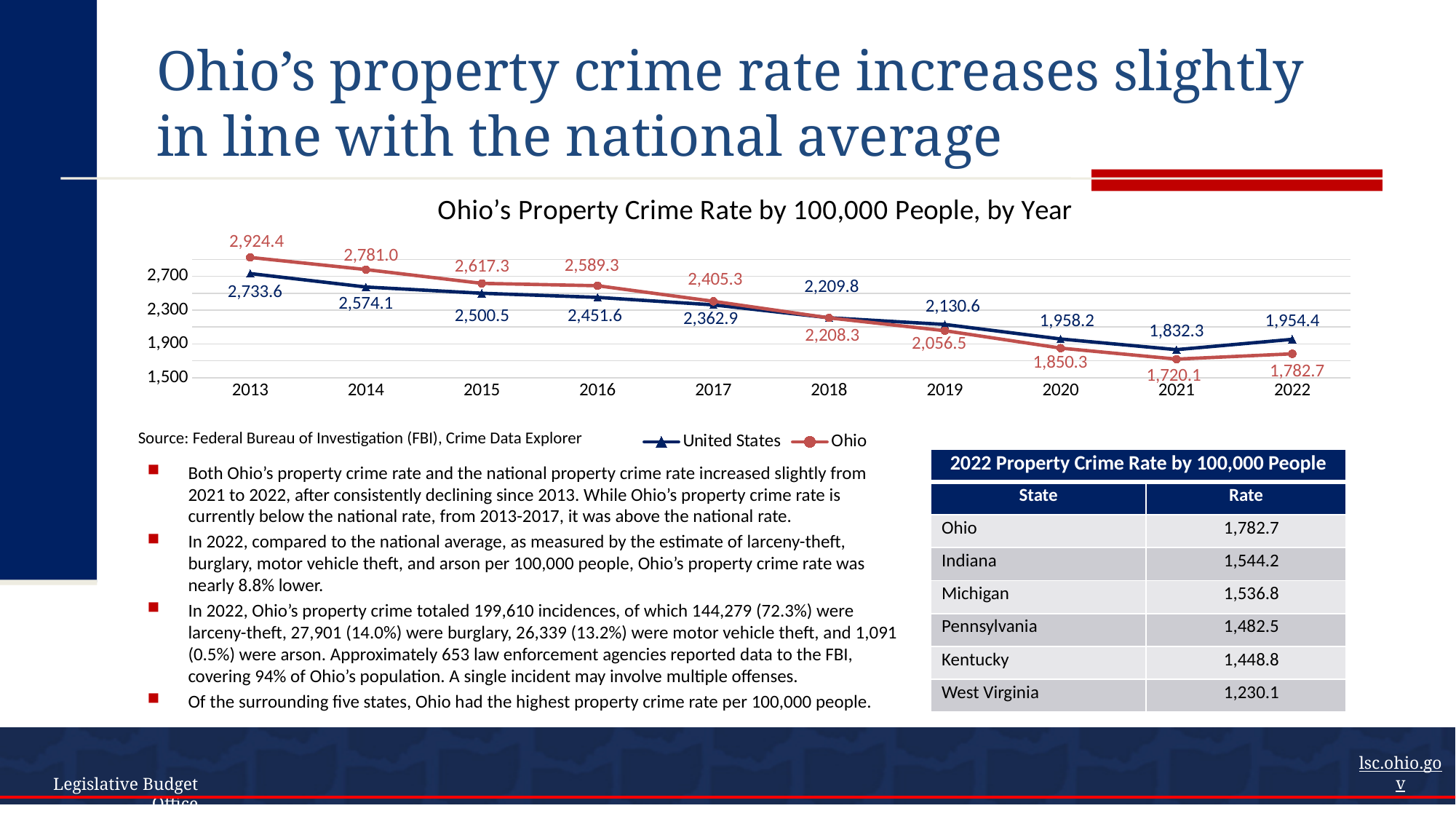
In 2015, which series has the higher property crime rate, United States or Ohio? Ohio What is Ohio's property crime rate in 2021 on the line chart? 1,720.1 What kind of chart is used to show Ohio's property crime rate by year? Line chart In which year is Ohio's property crime rate lowest on the line chart? 2021 In 2022, how much higher is the United States property crime rate than Ohio's? 171.7 What is the difference between Ohio's property crime rate in 2013 and in 2022? 1,141.7 How many years are shown on the x axis of the line chart? 10 What is Ohio's property crime rate in 2013 on the line chart? 2,924.4 In 2020, which series has the higher property crime rate, United States or Ohio? United States In which year is the United States property crime rate highest on the line chart? 2013 What is the United States property crime rate in 2022 on the line chart? 1,954.4 How many series does the legend of the line chart list? 2